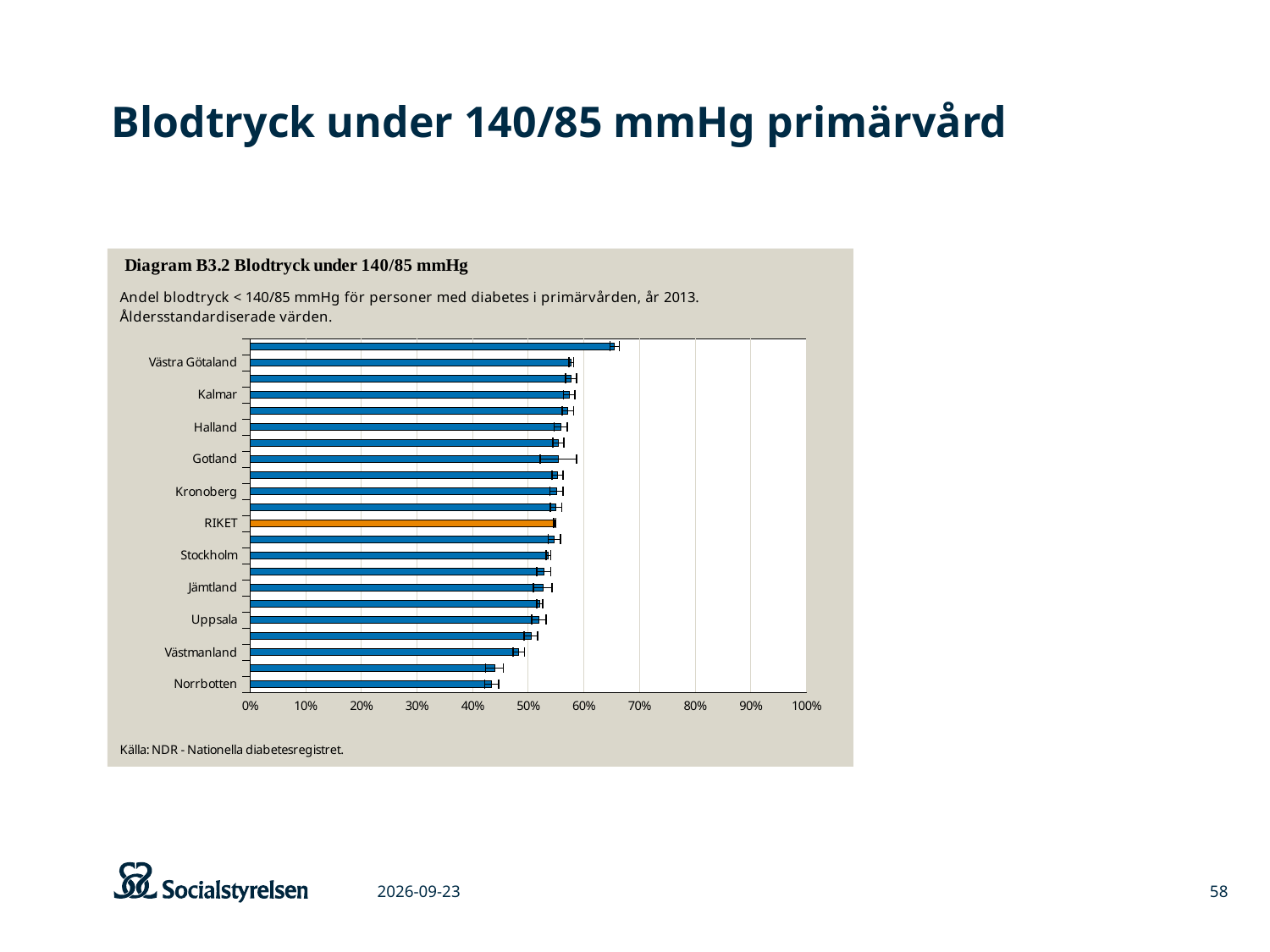
Is the value for Halland greater or less than 50%? greater Is the value for Västmanland greater or less than 50%? less Is the value for Norrbotten greater or less than 50%? less Which bar is shown in orange rather than blue? RIKET Which has a higher value, Kalmar or Västmanland? Kalmar Among the labeled regions, which has the lowest value? Norrbotten What is the source cited below the chart? NDR - Nationella diabetesregistret What kind of chart is shown on the slide? Bar chart Which has a higher value, Västra Götaland or Norrbotten? Västra Götaland